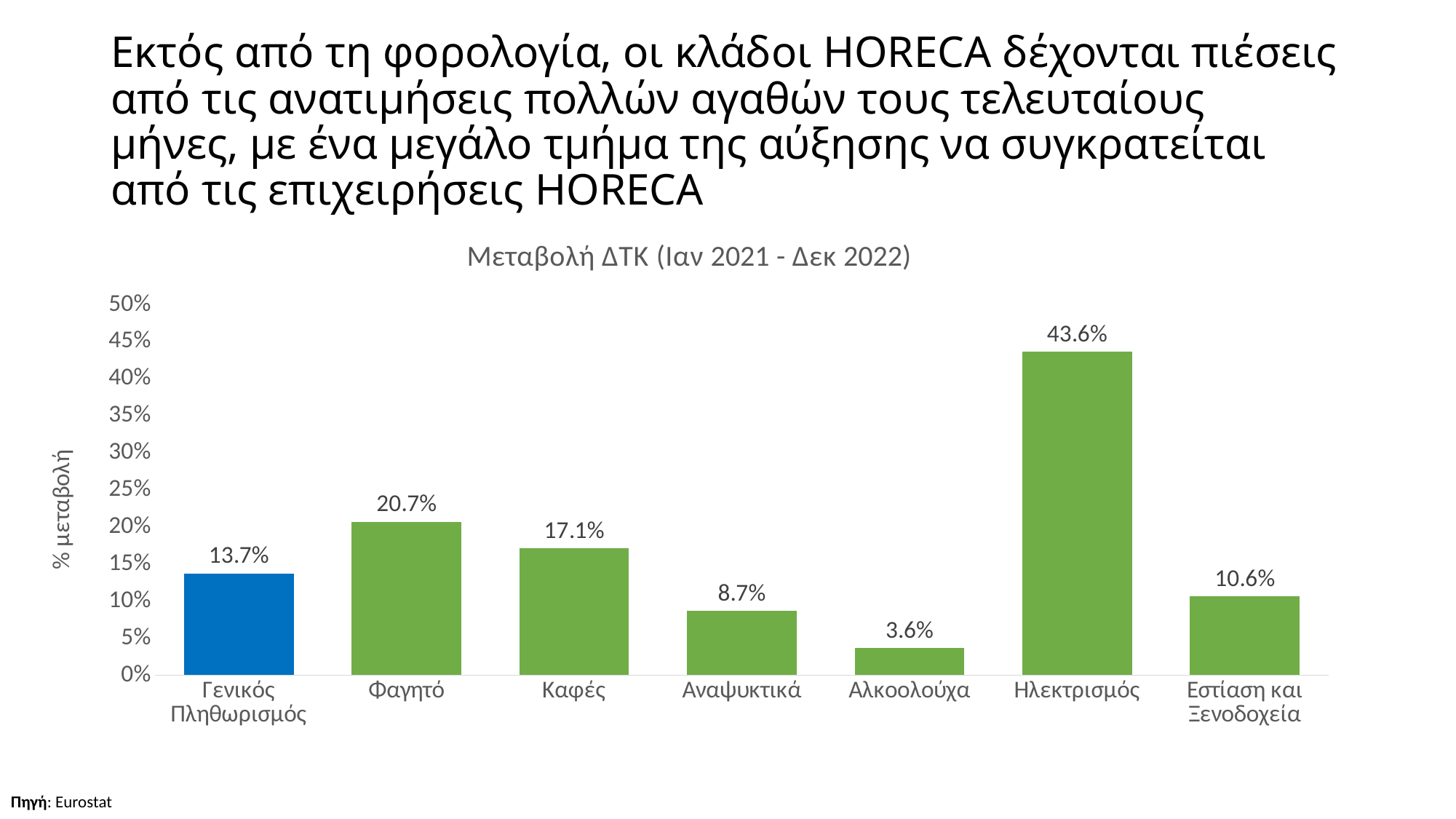
What is the difference between the values for Φαγητό and Καφές? 3.6% Which bar is coloured blue rather than green? Γενικός Πληθωρισμός What is the title of the chart? Μεταβολή ΔΤΚ (Ιαν 2021 - Δεκ 2022) Which category has the highest value? Ηλεκτρισμός How many categories are shown on the x axis? 7 What is the value for Ηλεκτρισμός? 43.6% What is the value for Γενικός Πληθωρισμός? 13.7% Which category has the lowest value? Αλκοολούχα Which is larger, the value for Αναψυκτικά or the value for Εστίαση και Ξενοδοχεία? Εστίαση και Ξενοδοχεία Is the value for Φαγητό greater or less than 20%? greater What is the value for Εστίαση και Ξενοδοχεία? 10.6% What kind of chart is shown on the slide? bar chart